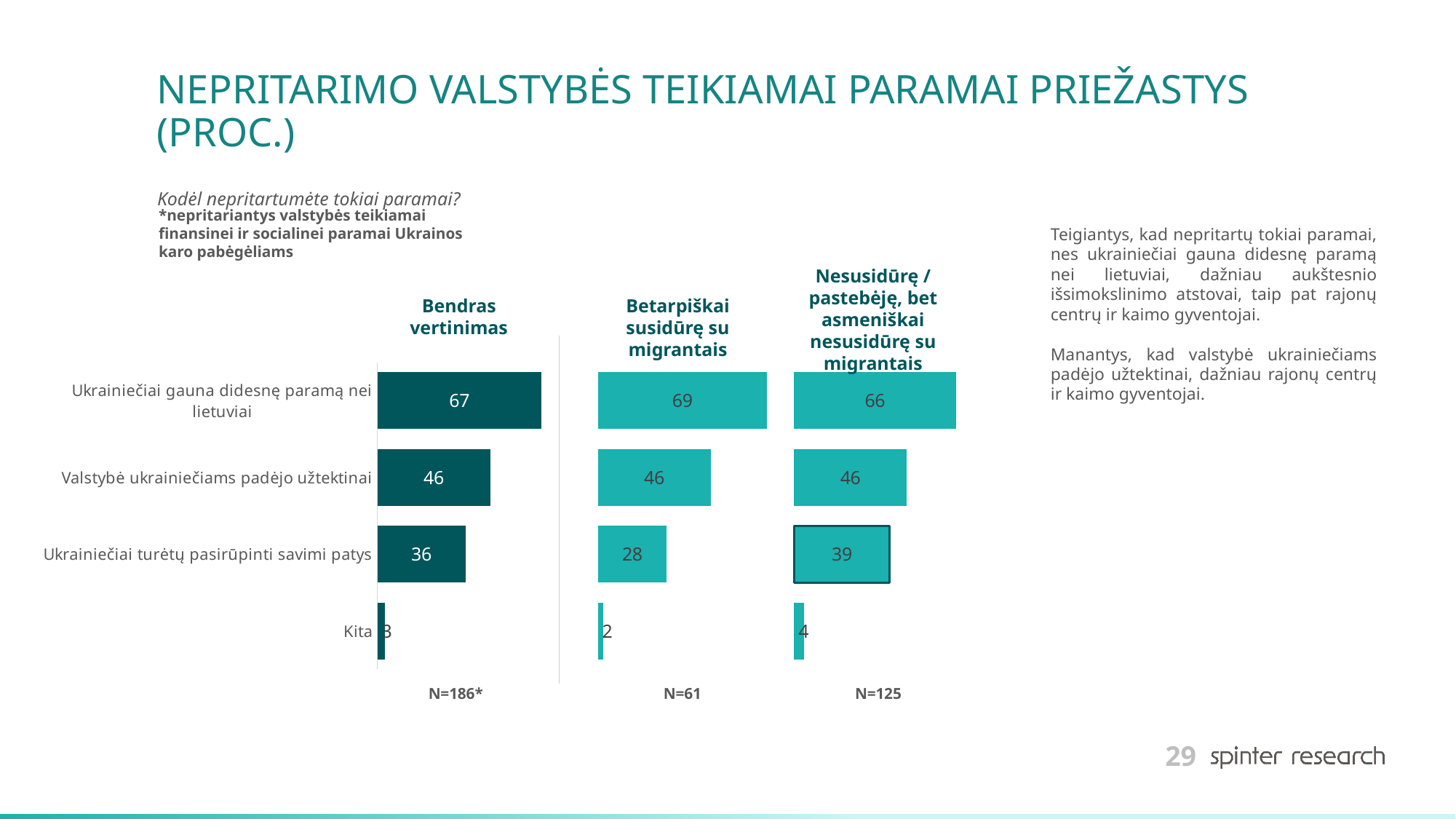
In the "Nesusidūrę / pastebėję, bet asmeniškai nesusidūrę su migrantais" chart, what is the value for "Ukrainiečiai turėtų pasirūpinti savimi patys"? 39 In the "Bendras vertinimas" chart, what is the value for "Kita"? 3 In the "Nesusidūrę / pastebėję, bet asmeniškai nesusidūrę su migrantais" chart, what is the value for "Kita"? 4 In the "Betarpiškai susidūrę su migrantais" chart, which category has the lowest value? Kita For "Ukrainiečiai turėtų pasirūpinti savimi patys", which is larger: the value in the "Betarpiškai susidūrę su migrantais" chart or the value in the "Nesusidūrę / pastebėję, bet asmeniškai nesusidūrę su migrantais" chart? Nesusidūrę / pastebėję, bet asmeniškai nesusidūrę su migrantais What is the sample size (N) shown under the "Betarpiškai susidūrę su migrantais" chart? N=61 In the "Betarpiškai susidūrę su migrantais" chart, what is the value for "Ukrainiečiai turėtų pasirūpinti savimi patys"? 28 How many categories are shown in the "Bendras vertinimas" chart? 4 In the "Bendras vertinimas" chart, what is the value for "Ukrainiečiai gauna didesnę paramą nei lietuviai"? 67 In the "Bendras vertinimas" chart, what is the difference between "Ukrainiečiai gauna didesnę paramą nei lietuviai" and "Valstybė ukrainiečiams padėjo užtektinai"? 21 What kind of chart is used on this slide? Bar chart In the "Bendras vertinimas" chart, which category has the highest value? Ukrainiečiai gauna didesnę paramą nei lietuviai